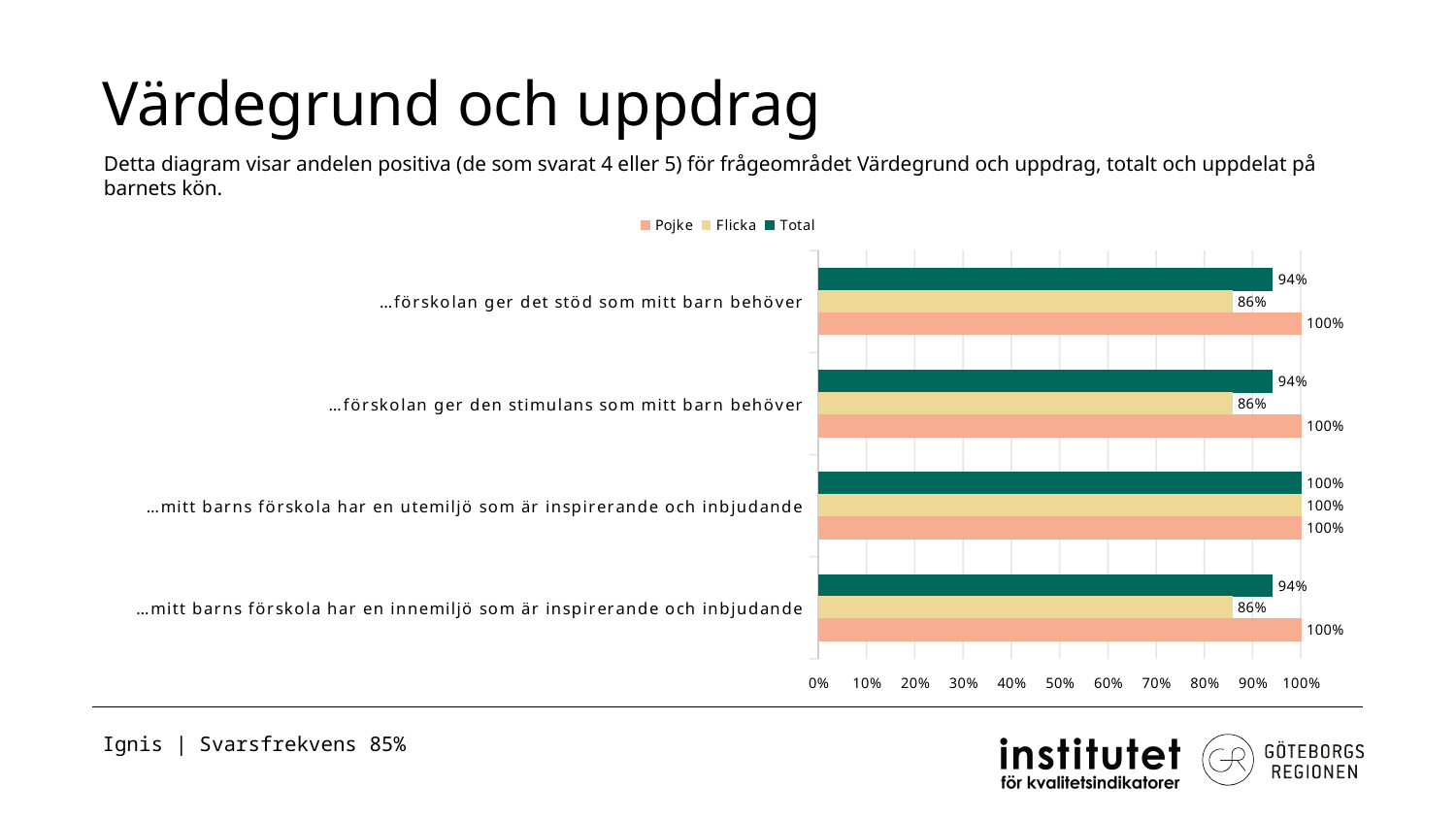
For "…förskolan ger den stimulans som mitt barn behöver", which is larger, the Pojke value or the Flicka value? Pojke What kind of chart is shown on the slide? bar chart What is the Pojke value for "…mitt barns förskola har en innemiljö som är inspirerande och inbjudande"? 100% Which series has the lowest value for "…mitt barns förskola har en innemiljö som är inspirerande och inbjudande"? Flicka How many categories (statements) are shown in the chart? 4 Which series is shown in dark green in the chart? Total What are the three legend entries of the chart? Pojke, Flicka, Total What is the difference between the Pojke and Flicka values for "…förskolan ger det stöd som mitt barn behöver"? 14% What is the Flicka value for "…förskolan ger den stimulans som mitt barn behöver"? 86% What is the Flicka value for "…mitt barns förskola har en utemiljö som är inspirerande och inbjudande"? 100% How many series does the legend list? 3 What is the Total value for "…förskolan ger det stöd som mitt barn behöver"? 94%